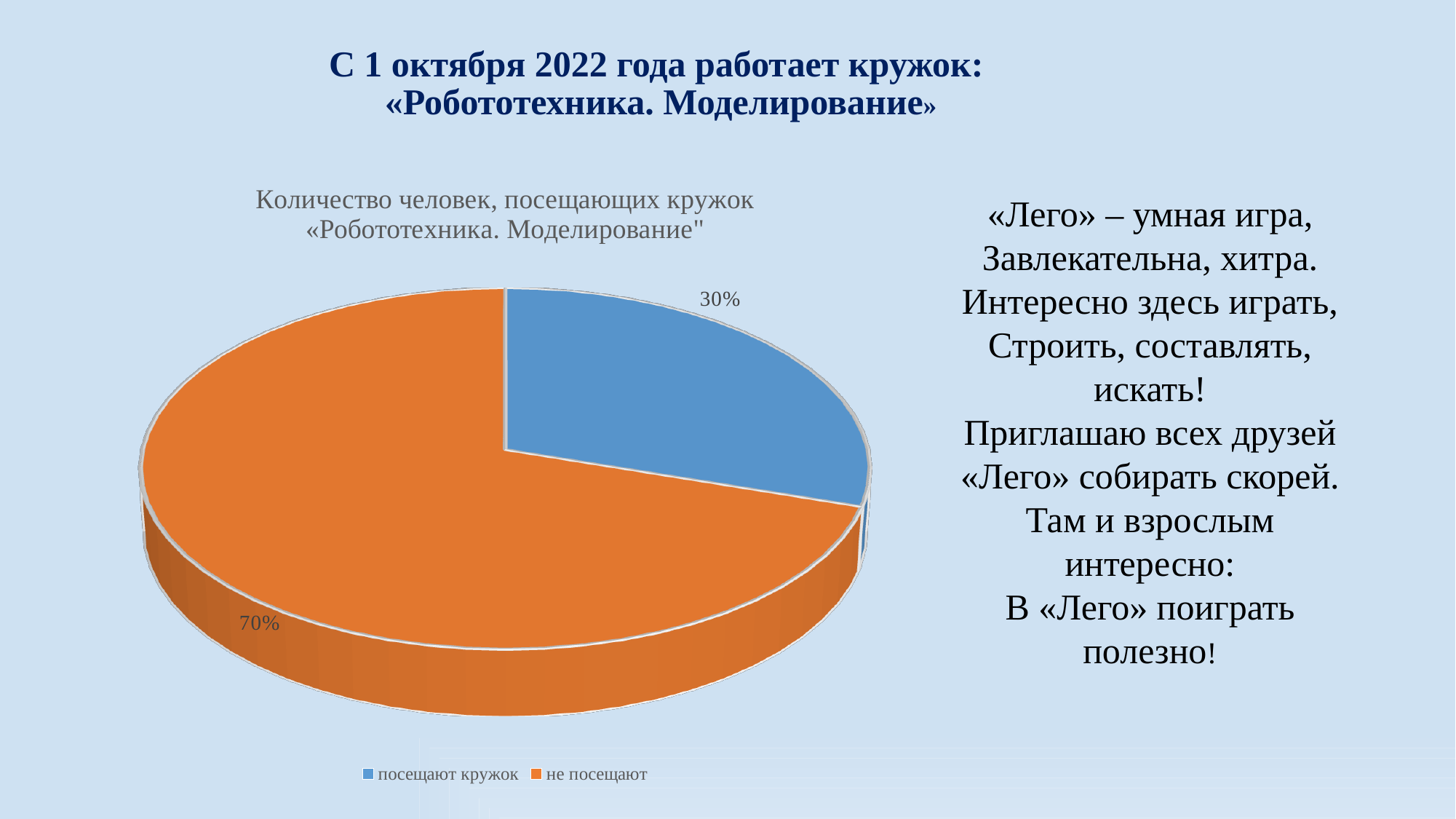
What colour is the slice for people who attend the club (посещают кружок)? Blue Which category has the smallest share of the pie? посещают кружок What type of chart is shown on the slide? Pie chart What is the difference in percentage points between those who do not attend and those who attend the club? 40 What is the title of the chart? Количество человек, посещающих кружок «Робототехника. Моделирование" Which category has the largest share of the pie? не посещают What percentage of people attend the club (посещают кружок)? 30% What share of the pie is taken by the orange slice? 70% How many entries does the legend list? 2 Which is larger: the share of people who attend the club or the share who do not attend? не посещают How many slices does the pie chart have? 2 What percentage of people do not attend the club (не посещают)? 70%